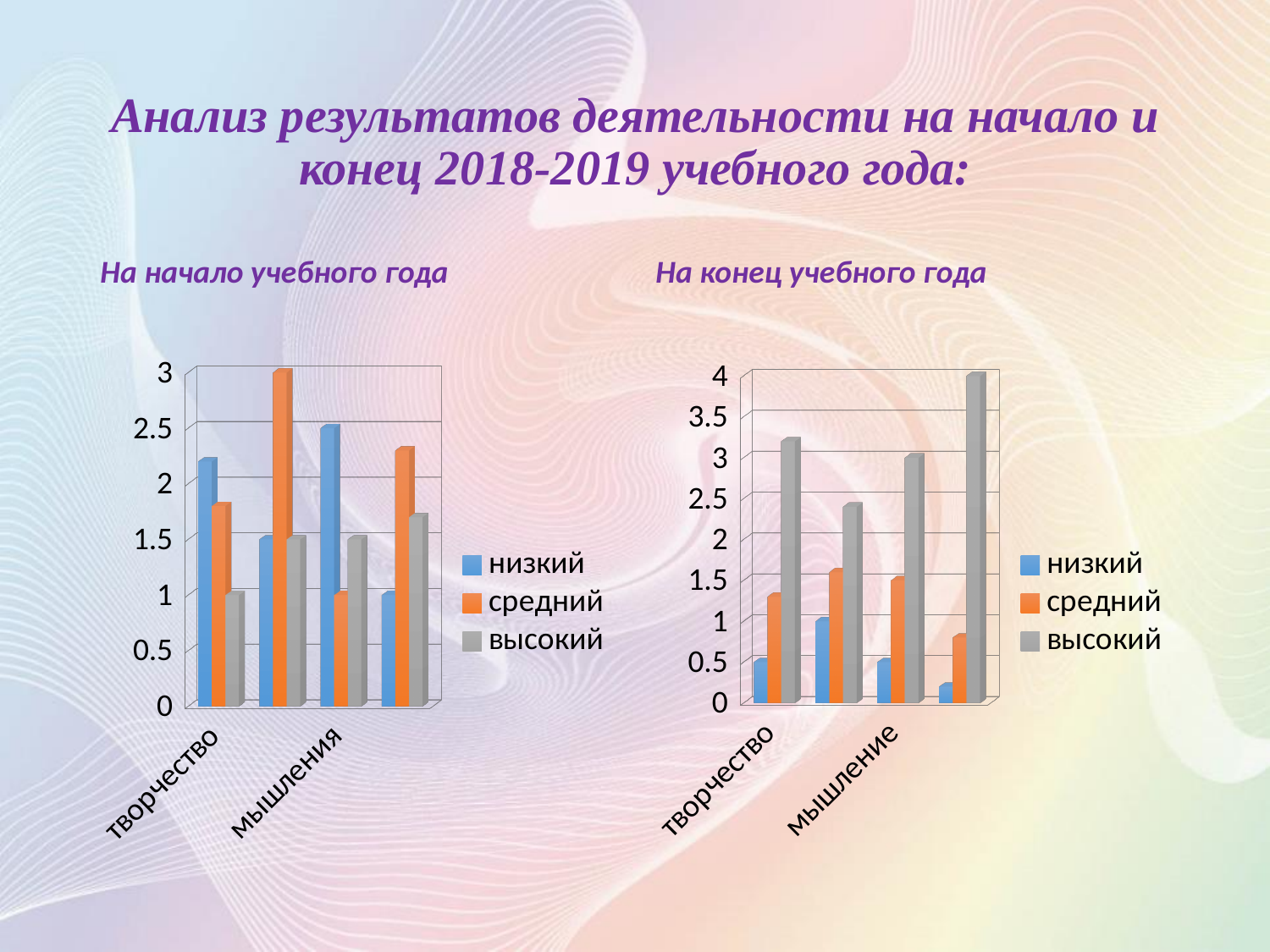
What are the legend entries of the chart titled "На начало учебного года"? низкий, средний, высокий In the chart titled "На начало учебного года", is the value of низкий for творчество greater or less than 2? greater What is the title of the chart on the right side of the slide? На конец учебного года In the chart titled "На конец учебного года", which series has the highest bar for творчество? высокий In the chart titled "На начало учебного года", which series reaches the tallest bar anywhere in the chart? средний In the chart titled "На начало учебного года", which series has the lowest bar for творчество? высокий In the chart titled "На конец учебного года", is the value of высокий for творчество greater or less than 3? greater In the chart titled "На начало учебного года", which series has the highest bar for творчество? низкий What kind of chart is the chart titled "На начало учебного года"? bar chart In the chart titled "На конец учебного года", is the value of средний for творчество larger than the value of низкий for творчество? yes How many series does the legend of the chart titled "На конец учебного года" list? 3 In the chart titled "На конец учебного года", which series has the lowest bar for творчество? низкий